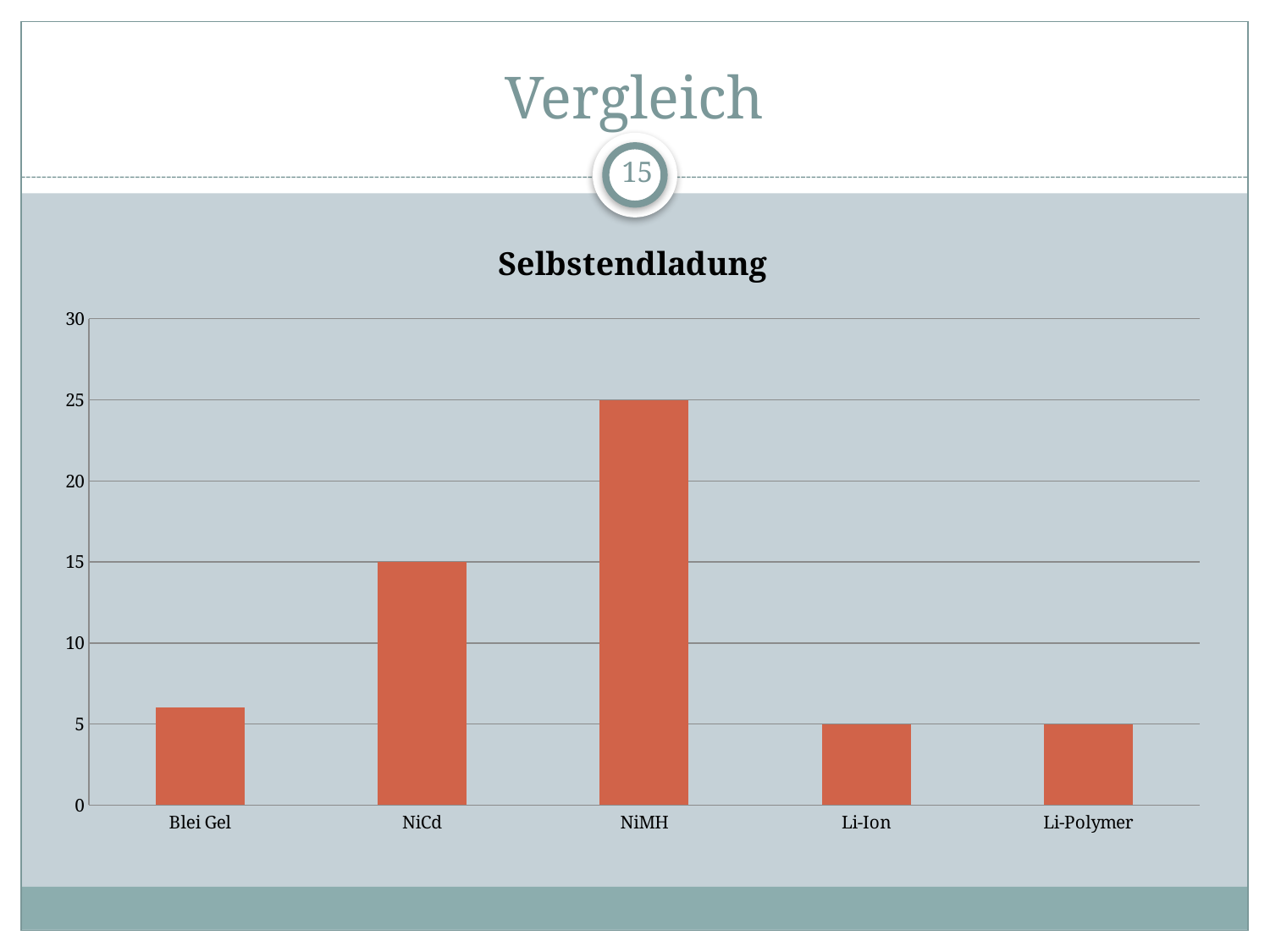
What is the value for NiCd? 15 What is the value for Li-Ion? 5 What is the difference between the values for NiMH and NiCd? 10 What is the value for NiMH? 25 What type of chart is shown on the slide? bar chart Is the value for NiMH greater or less than 20? greater Which is larger, the value for NiCd or the value for Blei Gel? NiCd What is the value for Li-Polymer? 5 What is the title of the chart? Selbstendladung Is the value for Blei Gel greater or less than 10? less Which category has the highest value? NiMH How many categories are shown on the x axis of the chart? 5